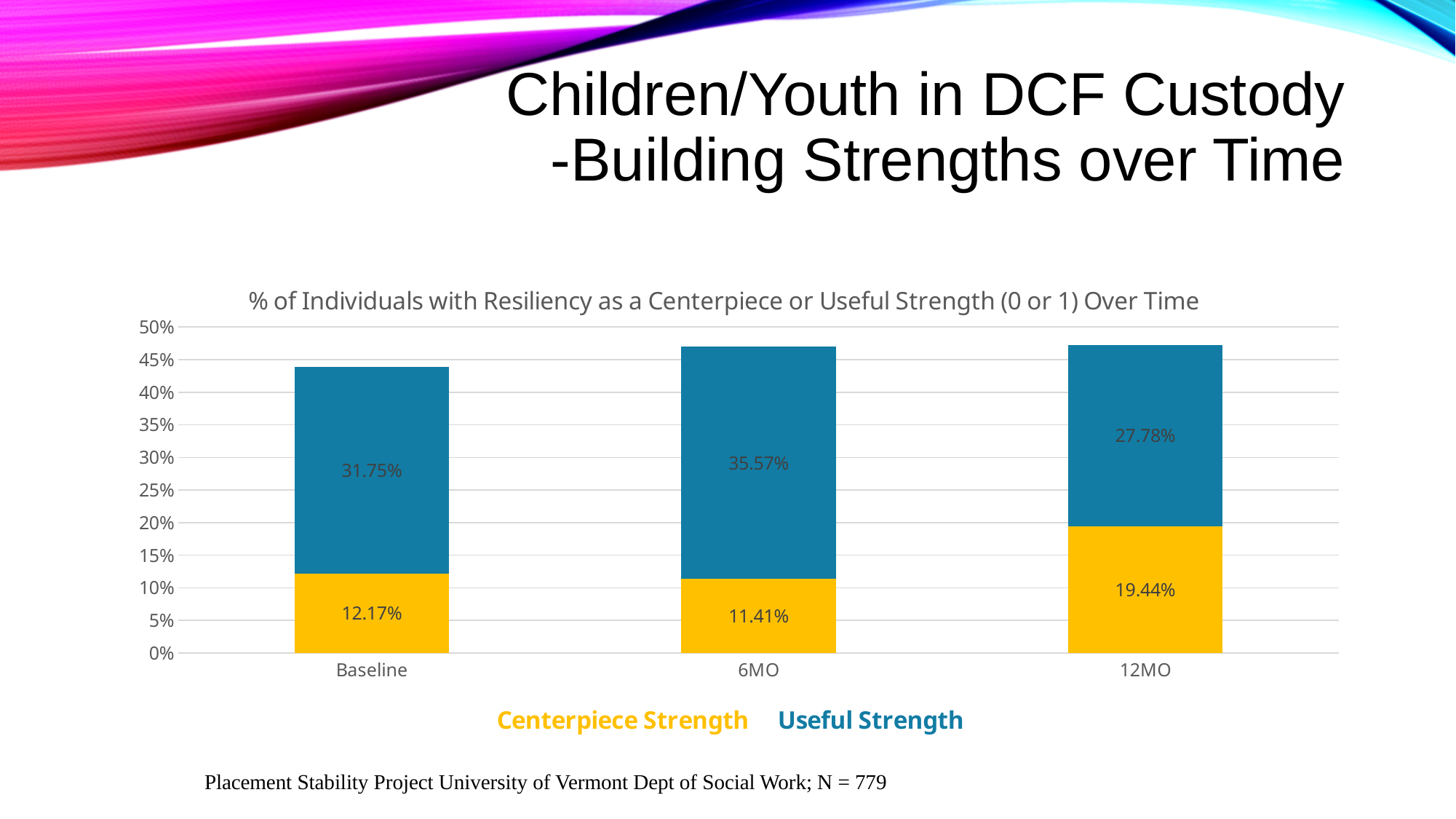
Is the total height of the Baseline stacked bar greater or less than 45%? less What is the Centerpiece Strength value at Baseline? 12.17% How many time points are shown on the x axis? 3 What is the total of the stacked bar at 12MO? 47.22% At which time point is the Centerpiece Strength value lowest? 6MO Which is larger, the Useful Strength value at Baseline or at 12MO? Baseline What is the difference between the Useful Strength values at 6MO and Baseline? 3.82% How many series does the legend list? 2 What kind of chart is shown on the slide? Stacked bar chart At which time point is the Useful Strength value highest? 6MO What is the Useful Strength value at 6MO? 35.57% What is the Centerpiece Strength value at 12MO? 19.44%